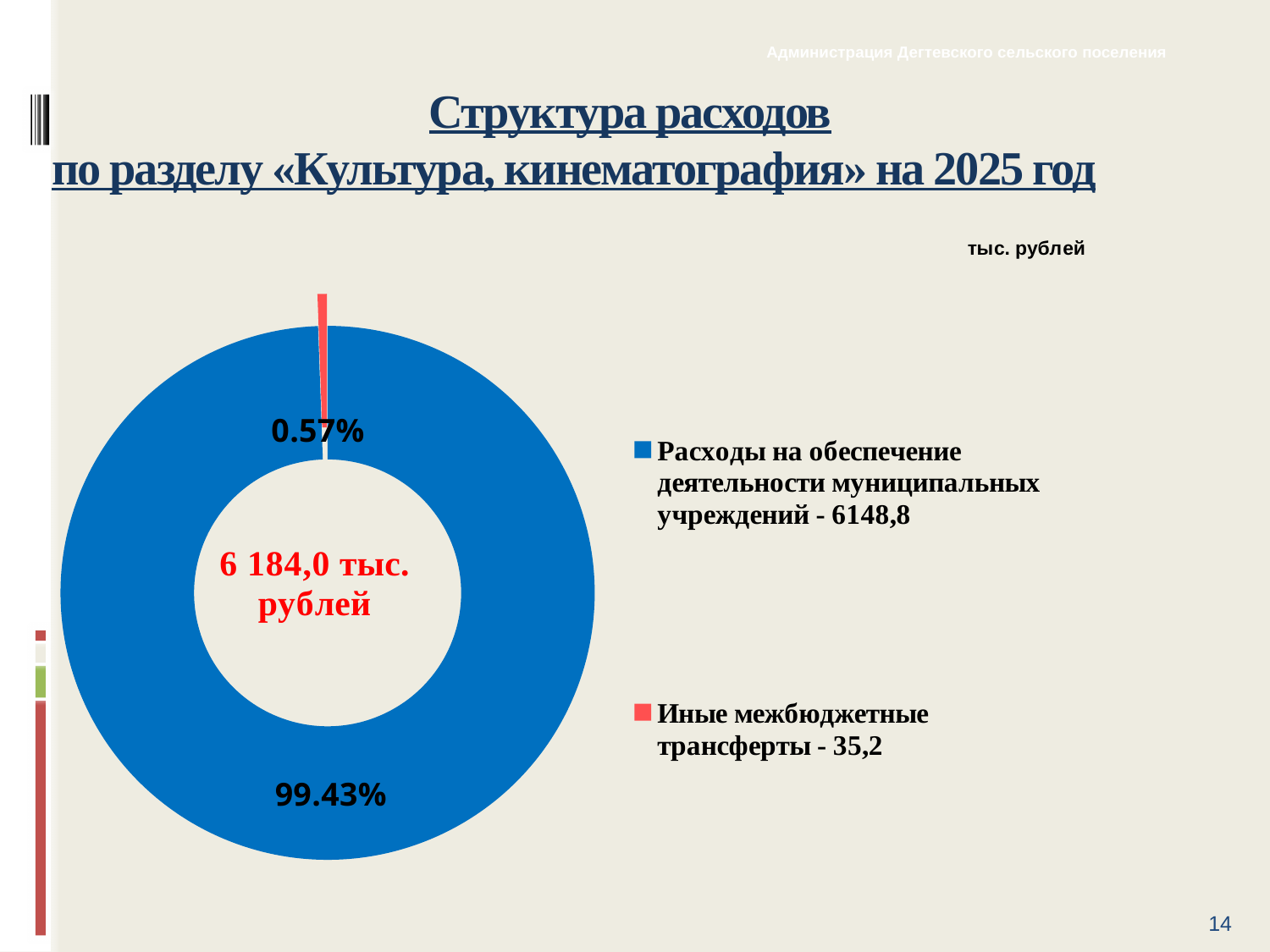
How many slices does the chart have? 2 What value does the legend give for Расходы на обеспечение деятельности муниципальных учреждений? 6148,8 What colour is the slice for Иные межбюджетные трансферты? Red What kind of chart is shown on the slide? Pie chart (doughnut) How many entries does the legend list? 2 Which is larger: Расходы на обеспечение деятельности муниципальных учреждений or Иные межбюджетные трансферты? Расходы на обеспечение деятельности муниципальных учреждений What share of the chart is labelled for the red slice (Иные межбюджетные трансферты)? 0.57% What total amount is printed in the centre of the chart? 6 184,0 тыс. рублей Which category has the largest share of the chart? Расходы на обеспечение деятельности муниципальных учреждений Which category has the smallest share of the chart? Иные межбюджетные трансферты What share of the chart is labelled for the blue slice (Расходы на обеспечение деятельности муниципальных учреждений)? 99.43% What value does the legend give for Иные межбюджетные трансферты? 35,2